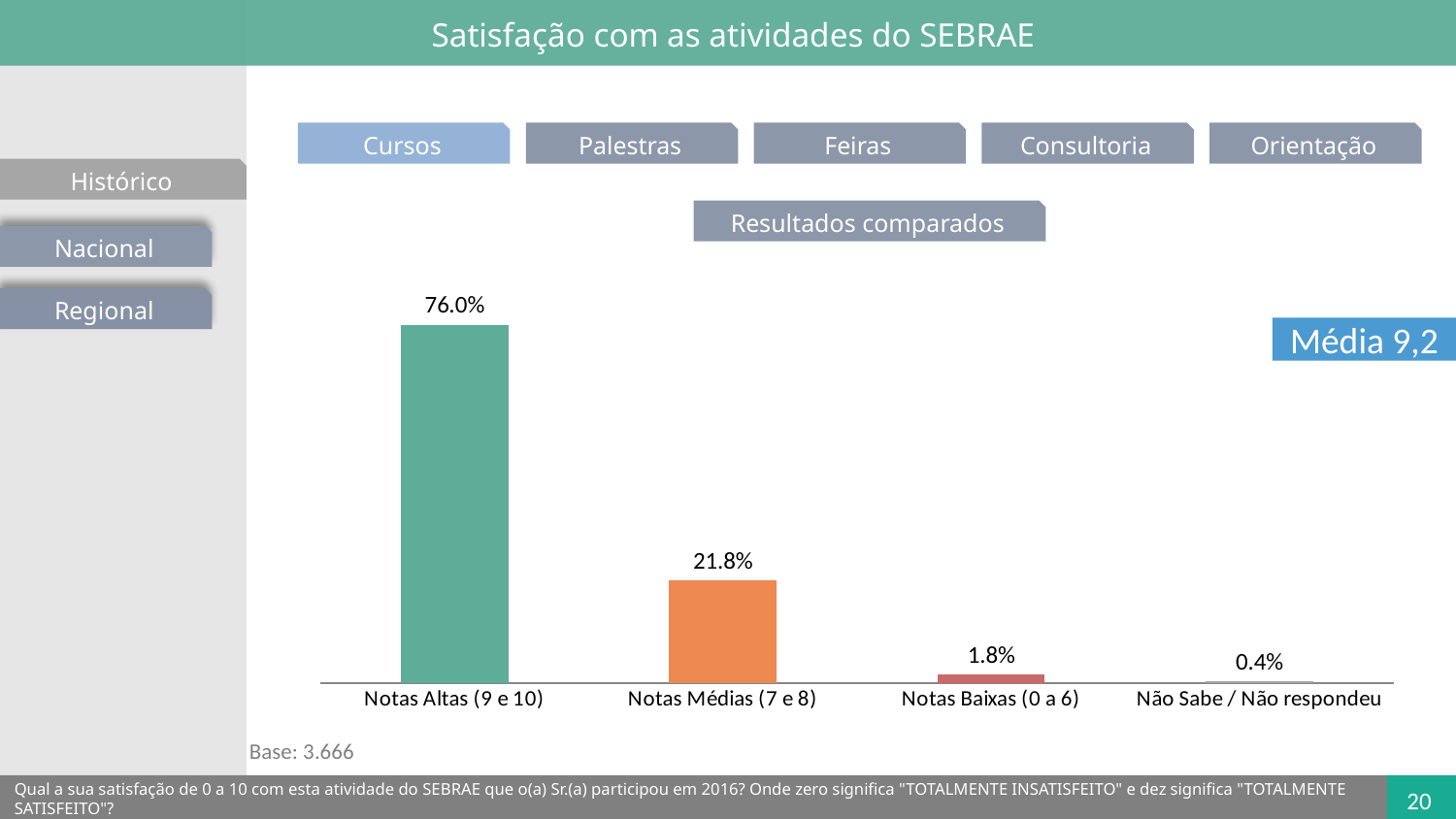
Do the values rise or fall from left to right across the categories? Fall What kind of chart is shown on the slide? Bar chart What is the difference between Notas Altas (9 e 10) and Notas Médias (7 e 8)? 54.2% What is the value for Notas Altas (9 e 10)? 76.0% Which is larger, Notas Baixas (0 a 6) or Não Sabe / Não respondeu? Notas Baixas (0 a 6) What is the value for Não Sabe / Não respondeu? 0.4% What is the value for Notas Médias (7 e 8)? 21.8% What is the value for Notas Baixas (0 a 6)? 1.8% How many categories are shown in the chart? 4 Which category has the lowest value? Não Sabe / Não respondeu Which category has the highest value? Notas Altas (9 e 10) What average (Média) is shown next to the chart? 9,2